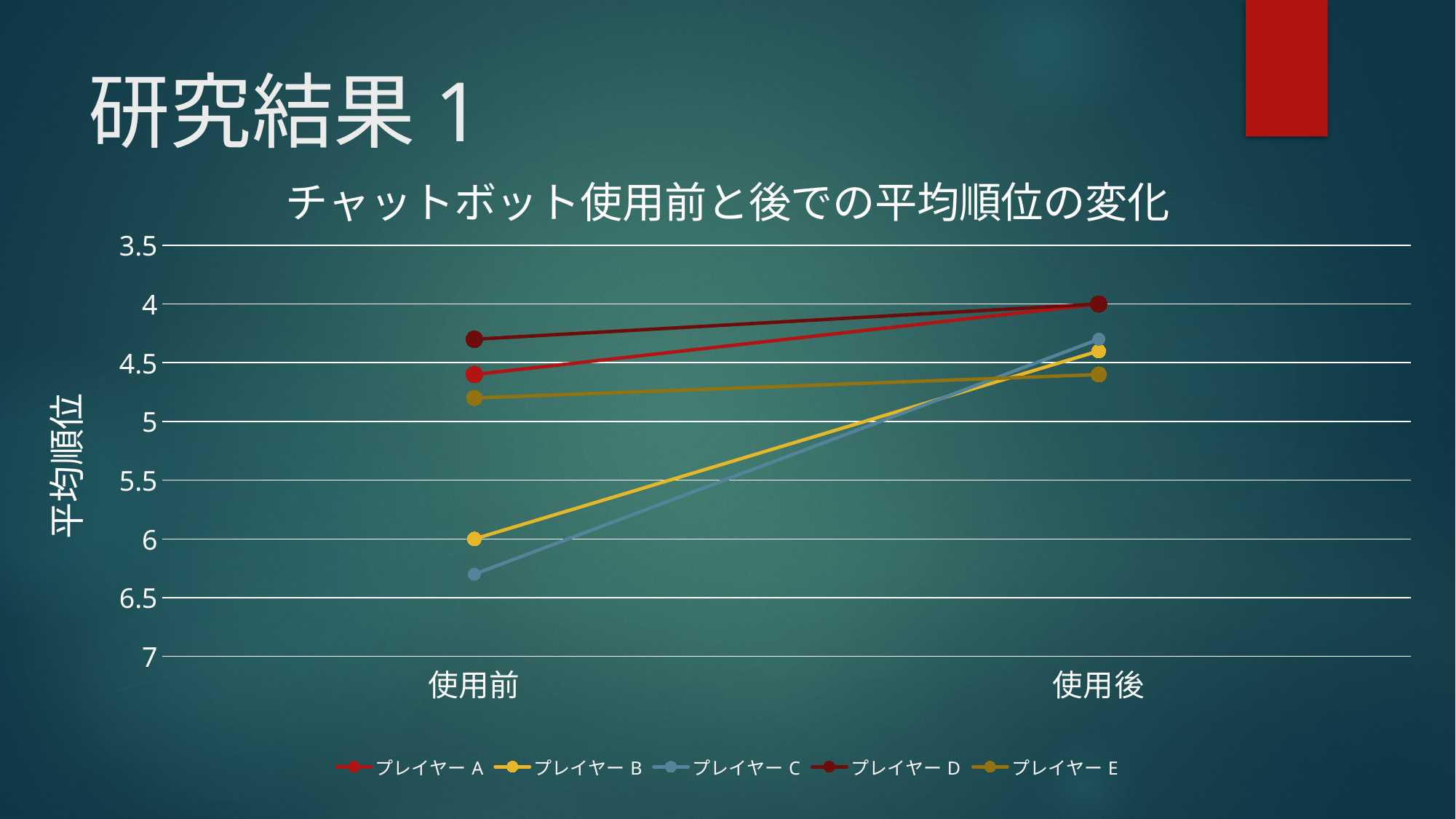
Which series has the highest value at 使用前? プレイヤー C Which series has the lowest value at 使用前? プレイヤー D How many categories are on the x axis? 2 Is the value for プレイヤー A at 使用前 greater or less than 5? less How many series does the legend list? 5 What is the value for プレイヤー D at 使用後? 4 What kind of chart is shown on the slide? line chart What is the title of the chart? チャットボット使用前と後での平均順位の変化 Is the value for プレイヤー C at 使用前 greater or less than 6? greater What is the value for プレイヤー B at 使用前? 6 At 使用前, which is larger, the value for プレイヤー B or プレイヤー D? プレイヤー B Is the value for プレイヤー E at 使用前 greater or less than 5? less